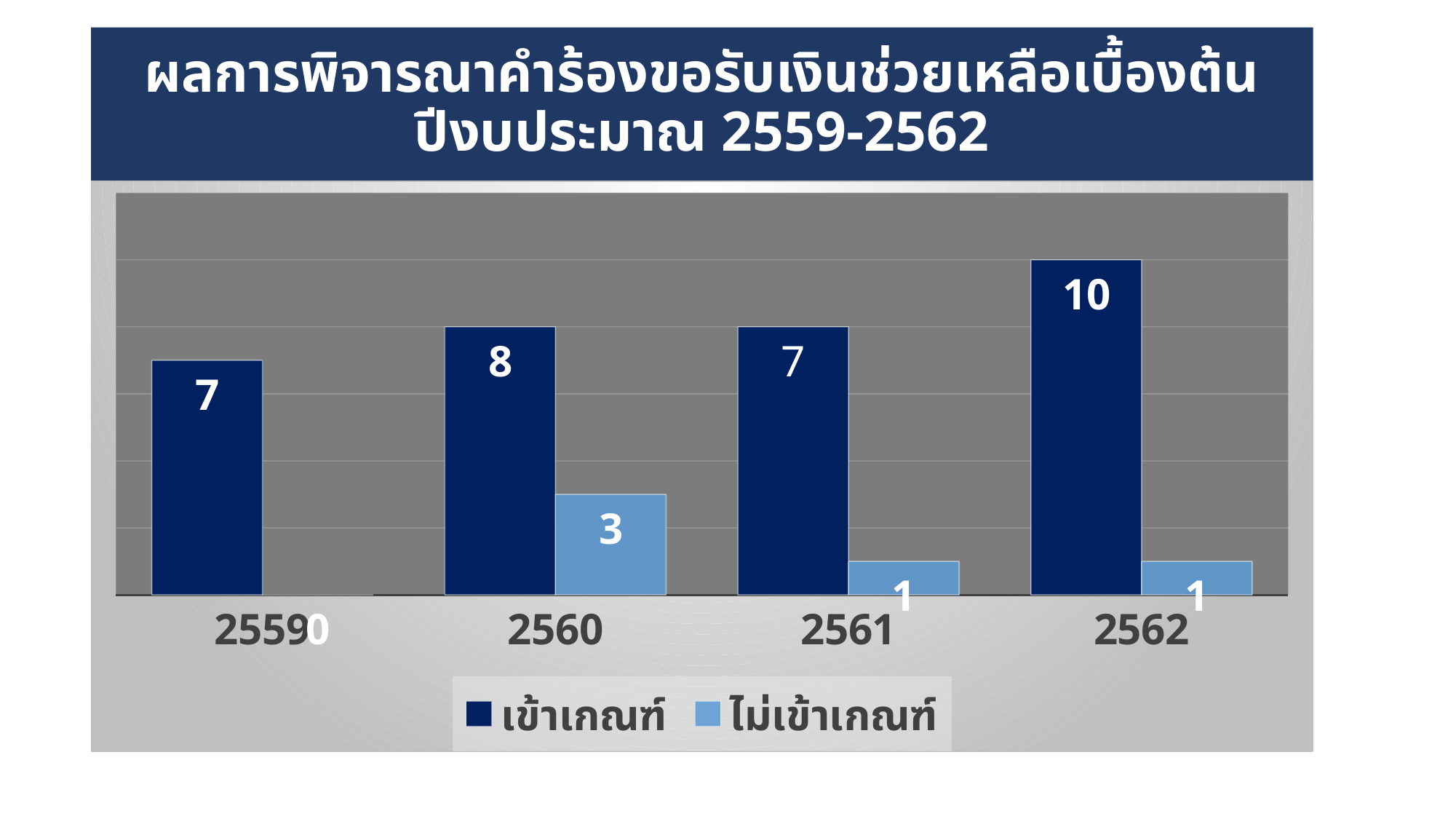
How many years are shown on the x axis? 4 What kind of chart is shown on the slide? Bar chart Which year has the highest value for เข้าเกณฑ์? 2562 Which year has the highest value for ไม่เข้าเกณฑ์? 2560 What is the value of เข้าเกณฑ์ for 2560? 8 What is the value of เข้าเกณฑ์ for 2562? 10 What is the value of ไม่เข้าเกณฑ์ for 2561? 1 How many series does the legend list? 2 What is the difference between the เข้าเกณฑ์ values for 2562 and 2560? 2 What is the difference between เข้าเกณฑ์ and ไม่เข้าเกณฑ์ in 2562? 9 What is the value of ไม่เข้าเกณฑ์ for 2560? 3